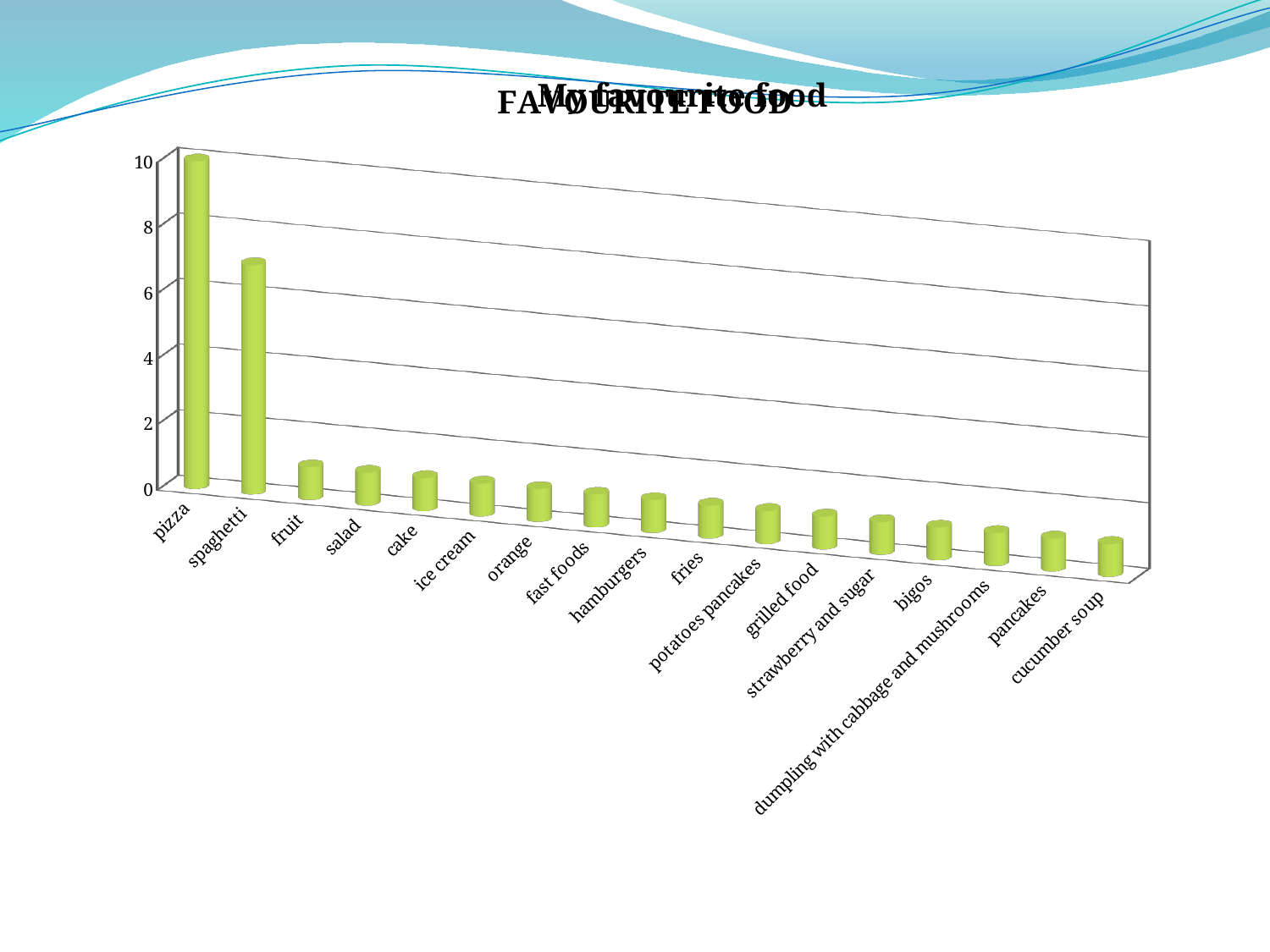
Which food has the highest value in the chart? pizza Which has a larger value, pizza or spaghetti? pizza Which has a larger value, spaghetti or fruit? spaghetti Is the value for pizza greater or less than 8? greater What kind of chart is shown on the slide? bar chart Is the value for spaghetti greater or less than 4? greater What colour are the bars in the chart? green Is the value for fruit greater or less than 2? less Do the values generally rise or fall moving from left to right along the x axis? fall Which category is listed first on the x axis? pizza How many food categories are shown on the x axis of the chart? 17